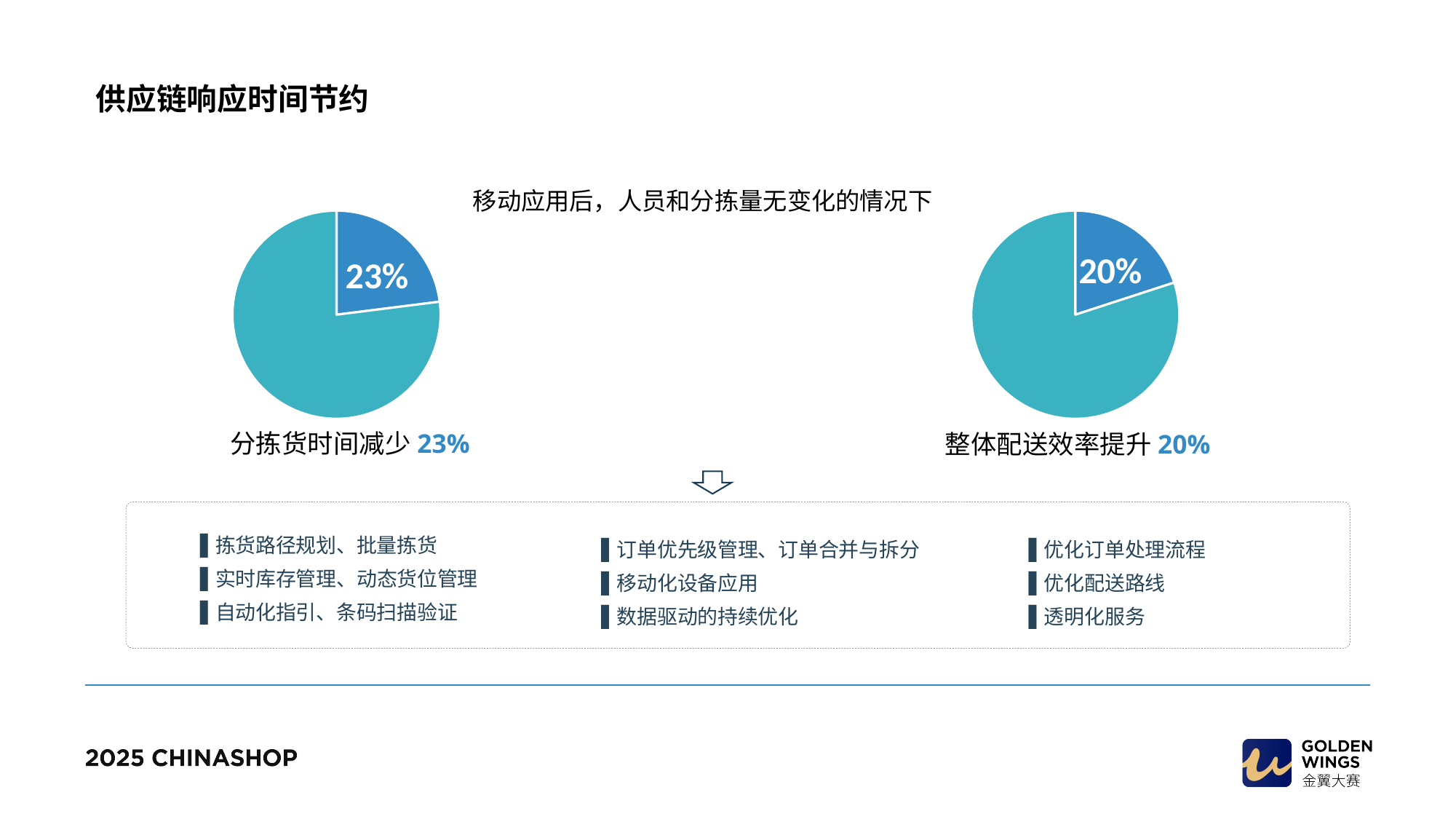
How many slices does the right pie chart have? 2 On the right pie chart, what share of the pie does the blue slice represent? 20% What kind of chart is the right chart (整体配送效率提升)? Pie chart What is the difference in percentage points between the labeled slice on the left pie (23%) and the labeled slice on the right pie (20%)? 3 percentage points On the right pie chart, what value is printed on the highlighted slice? 20% On the left pie chart, what value is printed on the highlighted slice? 23% What is the caption below the right pie chart? 整体配送效率提升 20% On the left pie chart, what share of the pie does the blue slice represent? 23% How many slices does the left pie chart have? 2 What colour is the labeled slice in each pie chart? Blue What kind of chart is the left chart (分拣货时间减少)? Pie chart Which labeled slice is larger: the 分拣货时间减少 slice on the left pie or the 整体配送效率提升 slice on the right pie? 分拣货时间减少 (23%)